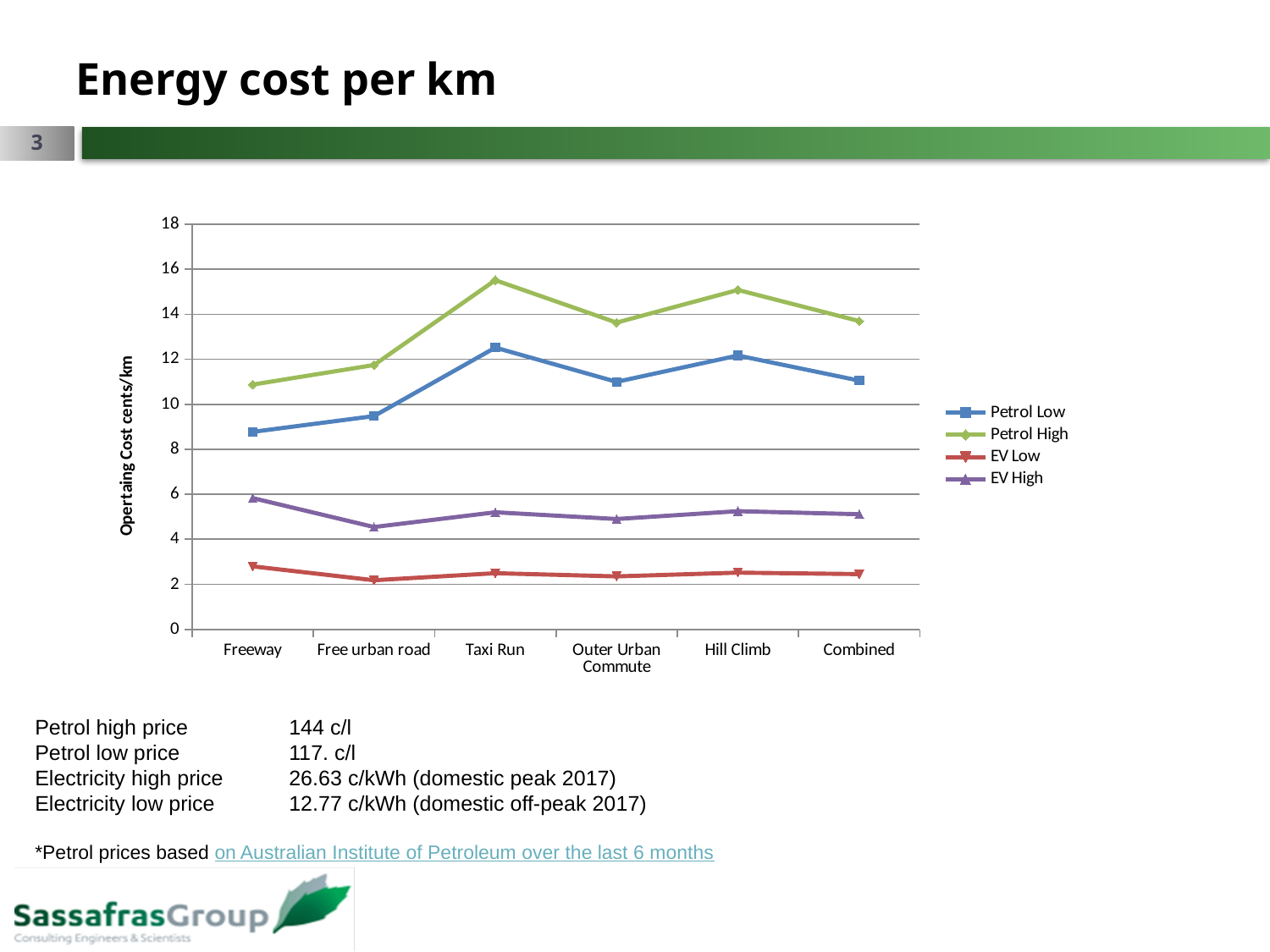
Is the EV Low value for Freeway greater or less than 4? less For the EV High series, which category has the highest value? Freeway Is the Petrol High value for Taxi Run greater or less than 14? greater How many categories are shown on the x axis? 6 Which series has the highest values across all categories? Petrol High At Taxi Run, which is larger: Petrol High or Petrol Low? Petrol High Is the Petrol Low value for Freeway greater or less than 10? less For the Petrol High series, which category has the lowest value? Freeway How many series does the legend list? 4 Which series has the lowest values across all categories? EV Low What is the label on the y axis? Opertaing Cost cents/km What kind of chart is shown on the slide? line chart